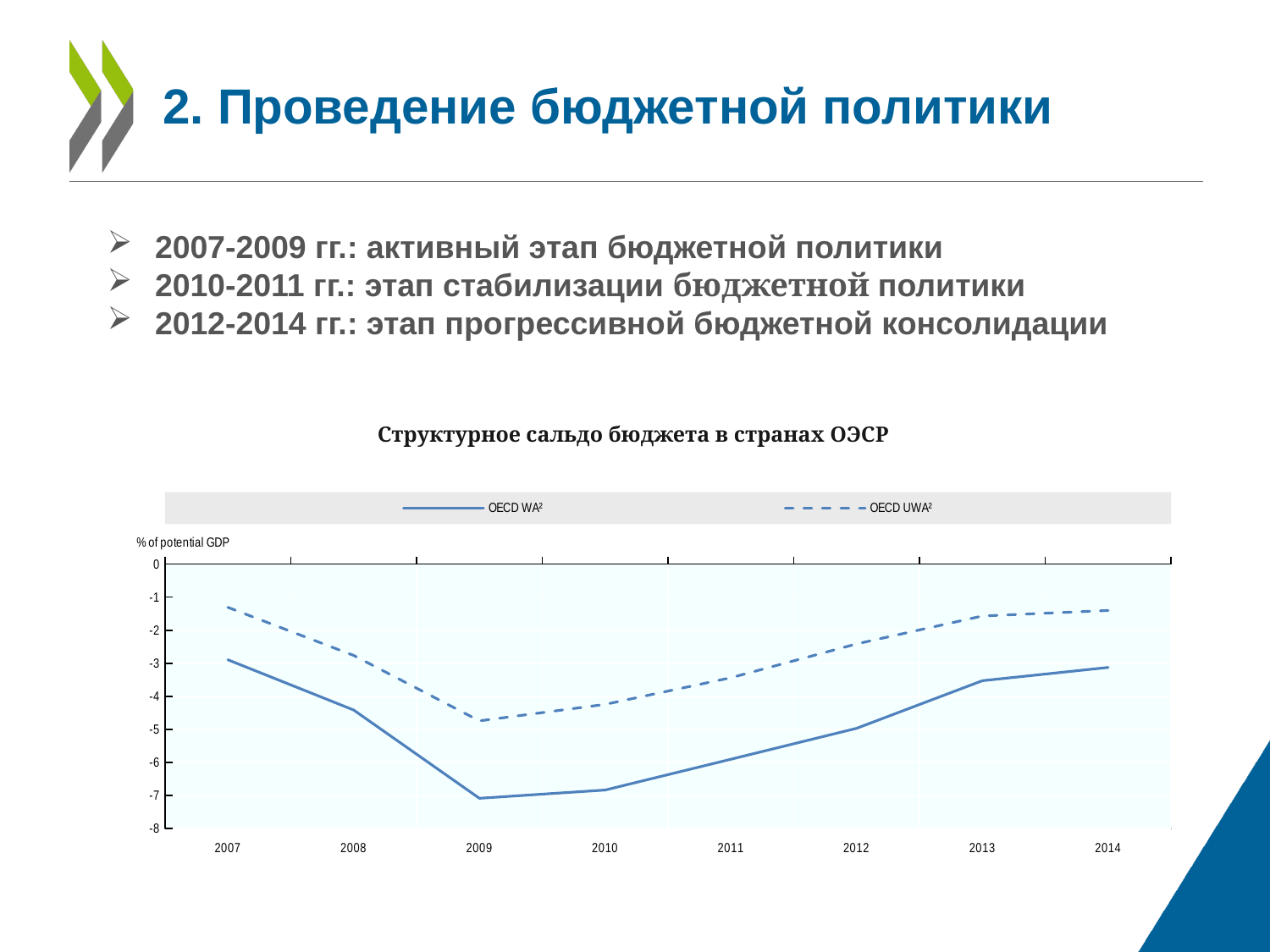
Is the OECD UWA² value for 2014 greater or less than -2? greater How many years are shown on the x axis of the chart? 8 In which year does the OECD WA² series reach its lowest value? 2009 Is the OECD UWA² value for 2007 greater or less than -2? greater What unit is shown on the vertical axis of the chart? % of potential GDP How many series does the chart legend list? 2 Do the OECD WA² values rise or fall from 2009 to 2014? rise Is the OECD WA² value for 2012 greater or less than -4? less In which year does the OECD UWA² series reach its lowest value? 2009 What kind of chart is shown on the slide? line chart In 2009, which series has the higher value, OECD WA² or OECD UWA²? OECD UWA²